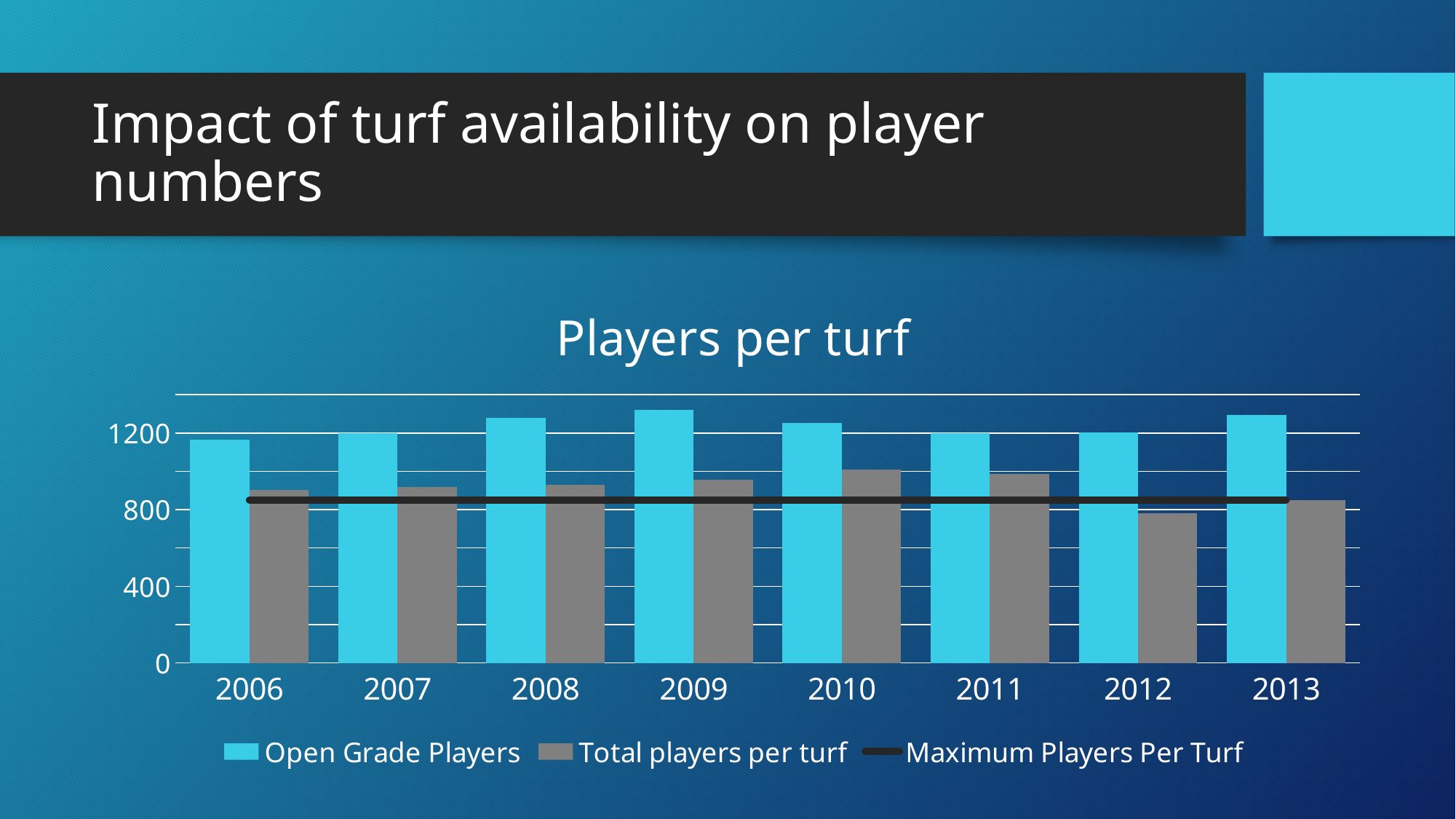
What is the title of the chart? Players per turf Is the value for Total players per turf in 2010 greater or less than 800? greater In which year is the Total players per turf bar the lowest? 2012 How many series does the legend list? 3 Is the value for Open Grade Players in 2008 greater or less than 1200? greater In which year is the Open Grade Players bar the highest? 2009 What kind of chart is shown on the slide? bar and line chart Which is larger, Open Grade Players in 2009 or Open Grade Players in 2006? 2009 Is the value for Total players per turf in 2006 greater or less than 1200? less Which colour represents Open Grade Players in the legend? light blue How many years are shown on the x axis? 8